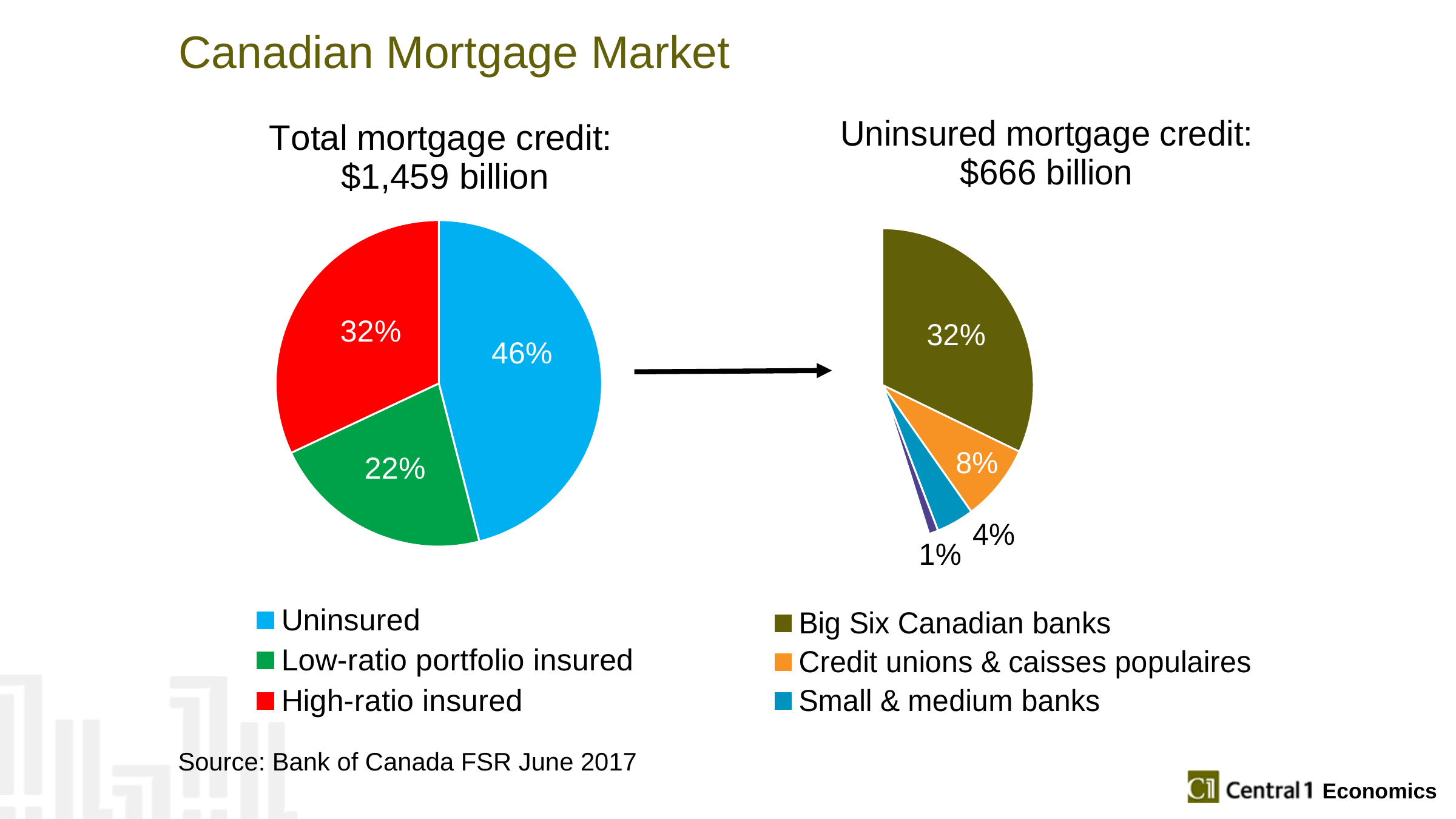
What type of chart is used for 'Total mortgage credit'? Pie chart In the 'Total mortgage credit' chart, which category has the smallest share? Low-ratio portfolio insured In the 'Total mortgage credit' chart, what share is Uninsured? 46% In the 'Uninsured mortgage credit' chart, what share is held by Small & medium banks? 4% In the 'Uninsured mortgage credit' chart, what share is held by Big Six Canadian banks? 32% In the 'Total mortgage credit' chart, what share is Low-ratio portfolio insured? 22% In the 'Total mortgage credit' chart, which category has the largest share? Uninsured In the 'Uninsured mortgage credit' chart, what share is held by Credit unions & caisses populaires? 8% In the 'Total mortgage credit' chart, what is the difference in percentage points between Uninsured and High-ratio insured? 14 How many entries does the legend of the 'Uninsured mortgage credit' chart list? 3 In the 'Total mortgage credit' chart, what share is High-ratio insured? 32% In the 'Uninsured mortgage credit' chart, which is larger: Credit unions & caisses populaires or Small & medium banks? Credit unions & caisses populaires